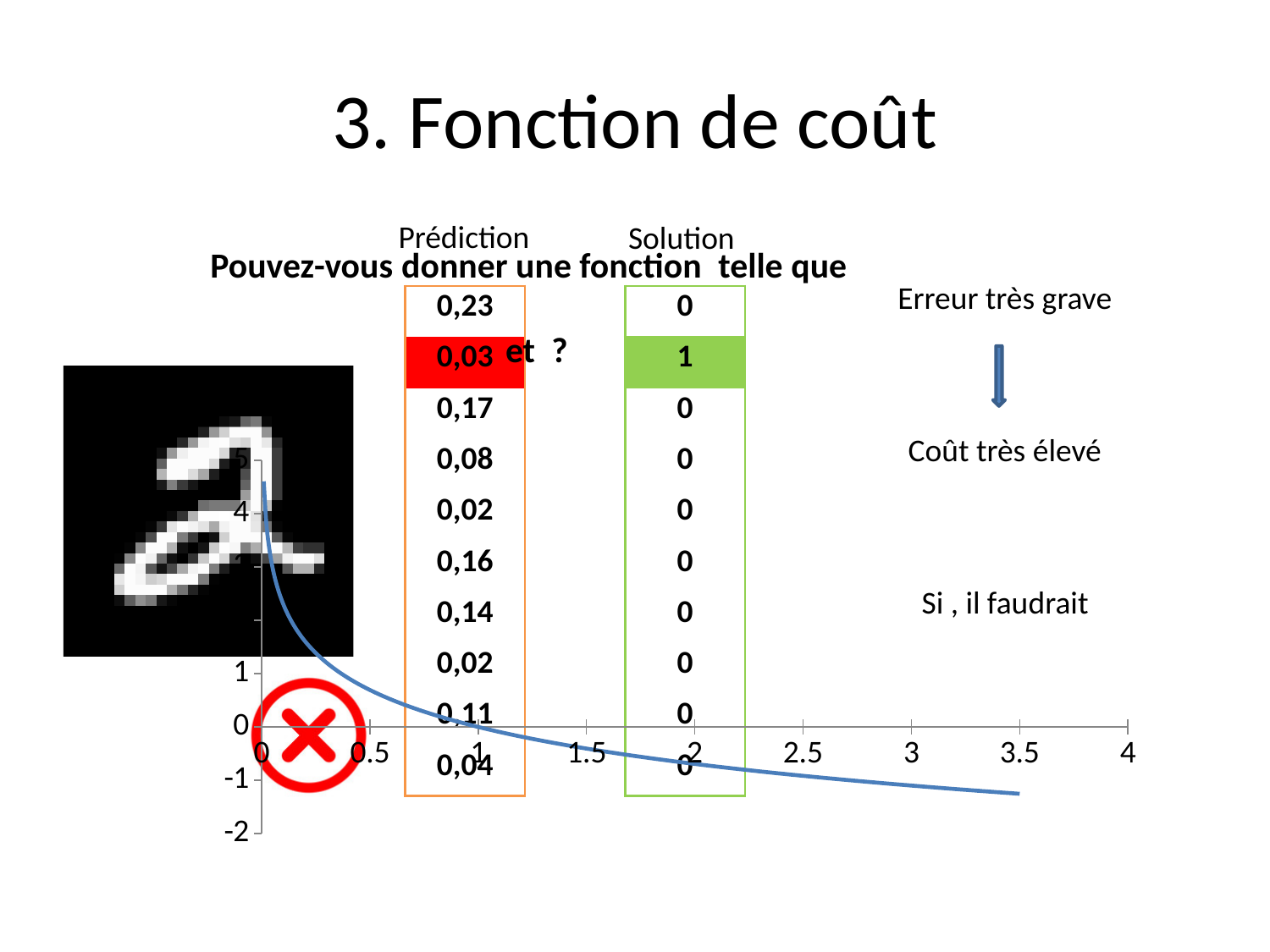
Is the value of the curve at x = 1.5 greater or less than 1? less What is the lowest value labelled on the y axis? -2 Does the plotted curve rise or fall as x increases? fall What is the largest value labelled on the x axis? 4 What kind of chart is shown on the slide? line chart Is the value of the curve at x = 3.5 greater or less than -2? greater Is the value of the curve at x = 3 greater or less than -2? greater